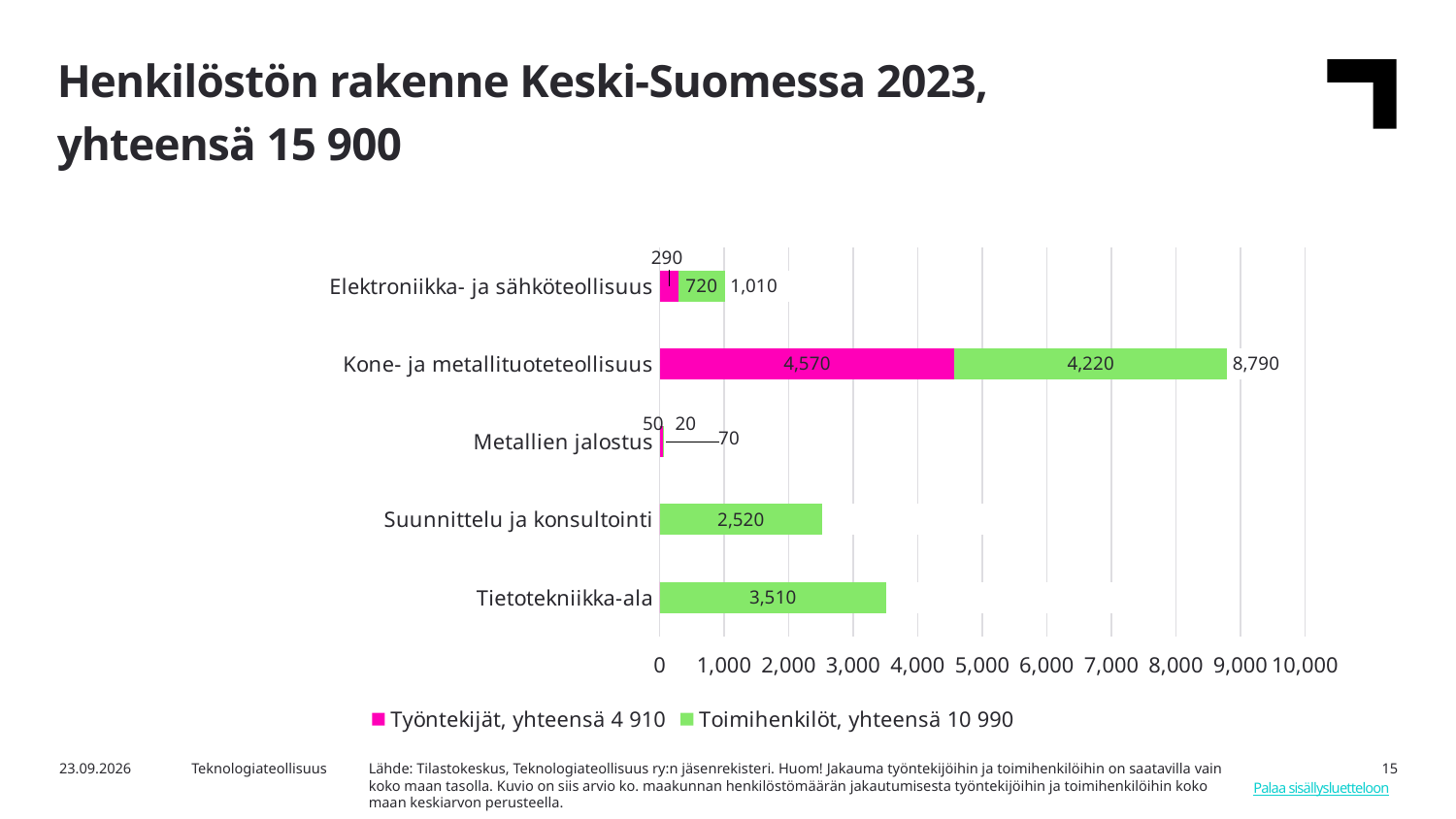
Which category has the lowest total value? Metallien jalostus What is the Toimihenkilöt value for Tietotekniikka-ala? 3,510 What is the Työntekijät value for Kone- ja metallituoteteollisuus? 4,570 What total for Työntekijät is given in the legend? 4 910 What type of chart is shown on the slide? Stacked bar chart What is the difference between the Työntekijät and Toimihenkilöt values for Kone- ja metallituoteteollisuus? 350 Which category has the highest total value? Kone- ja metallituoteteollisuus What is the total shown for the Kone- ja metallituoteteollisuus bar? 8,790 How many categories are shown on the chart? 5 What is the Toimihenkilöt value for Elektroniikka- ja sähköteollisuus? 720 How many series does the legend list? 2 Which is larger: the Toimihenkilöt value for Suunnittelu ja konsultointi or for Tietotekniikka-ala? Tietotekniikka-ala